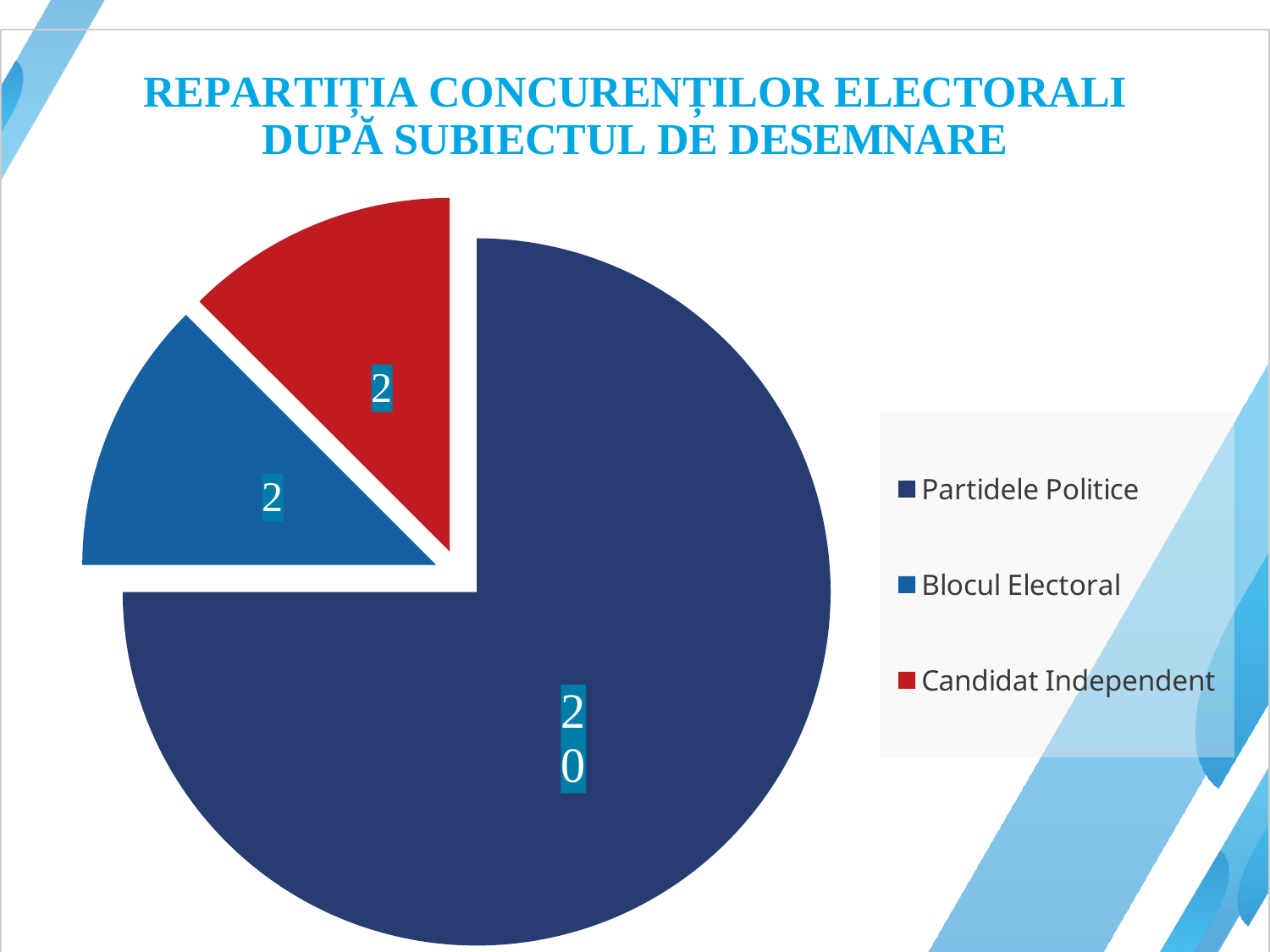
What is the value for Partidele Politice? 20 What type of chart is shown on the slide? pie chart What colour is the slice for Candidat Independent? red How many entries does the legend list? 3 Which is larger, the value for Partidele Politice or the value for Candidat Independent? Partidele Politice Which category has the largest slice of the pie? Partidele Politice What is the value for Blocul Electoral? 2 How many categories (slices) does the pie chart have? 3 What is the total of all the slices in the pie chart? 24 What is the difference between the values for Partidele Politice and Blocul Electoral? 18 What is the value for Candidat Independent? 2